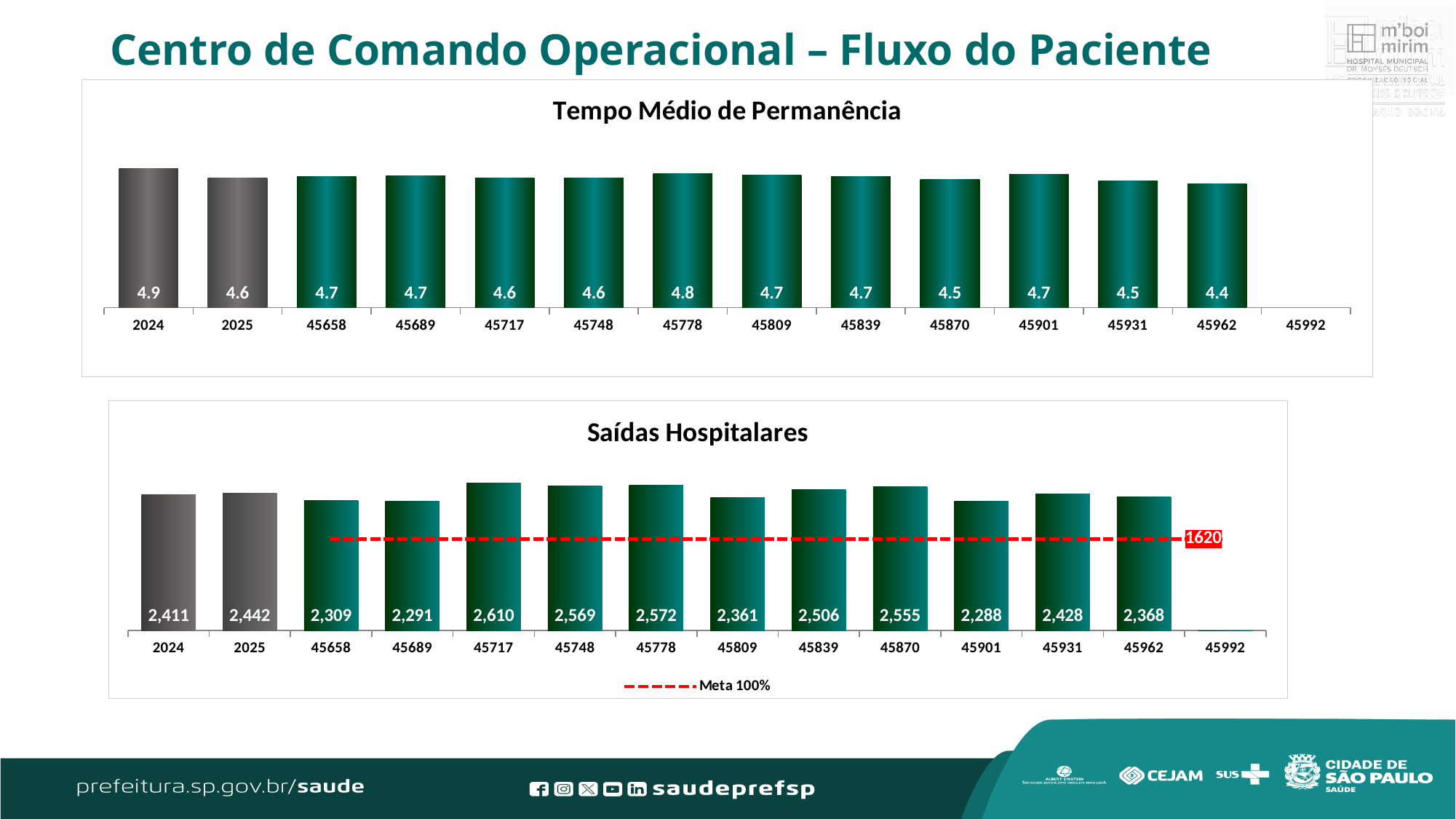
In the 'Saídas Hospitalares' chart, what value is shown for the 'Meta 100%' line? 1620 In the 'Saídas Hospitalares' chart, what is the value for 45717? 2,610 In the 'Saídas Hospitalares' chart, what is the difference between the values for 45748 and 45809? 208 In the 'Saídas Hospitalares' chart, which is larger, the value for 2024 or the value for 2025? 2025 In the 'Saídas Hospitalares' chart, which category has the highest value? 45717 In the 'Tempo Médio de Permanência' chart, how many bars have a data label? 13 In the 'Tempo Médio de Permanência' chart, which category has the lowest value? 45962 In the 'Tempo Médio de Permanência' chart, what is the value for 2024? 4.9 In the 'Tempo Médio de Permanência' chart, which category has the highest value? 2024 What kind of chart is 'Saídas Hospitalares'? Combination bar and line chart In the 'Saídas Hospitalares' chart, which category has the lowest value? 45901 In the 'Tempo Médio de Permanência' chart, what is the difference between the values for 2024 and 2025? 0.3